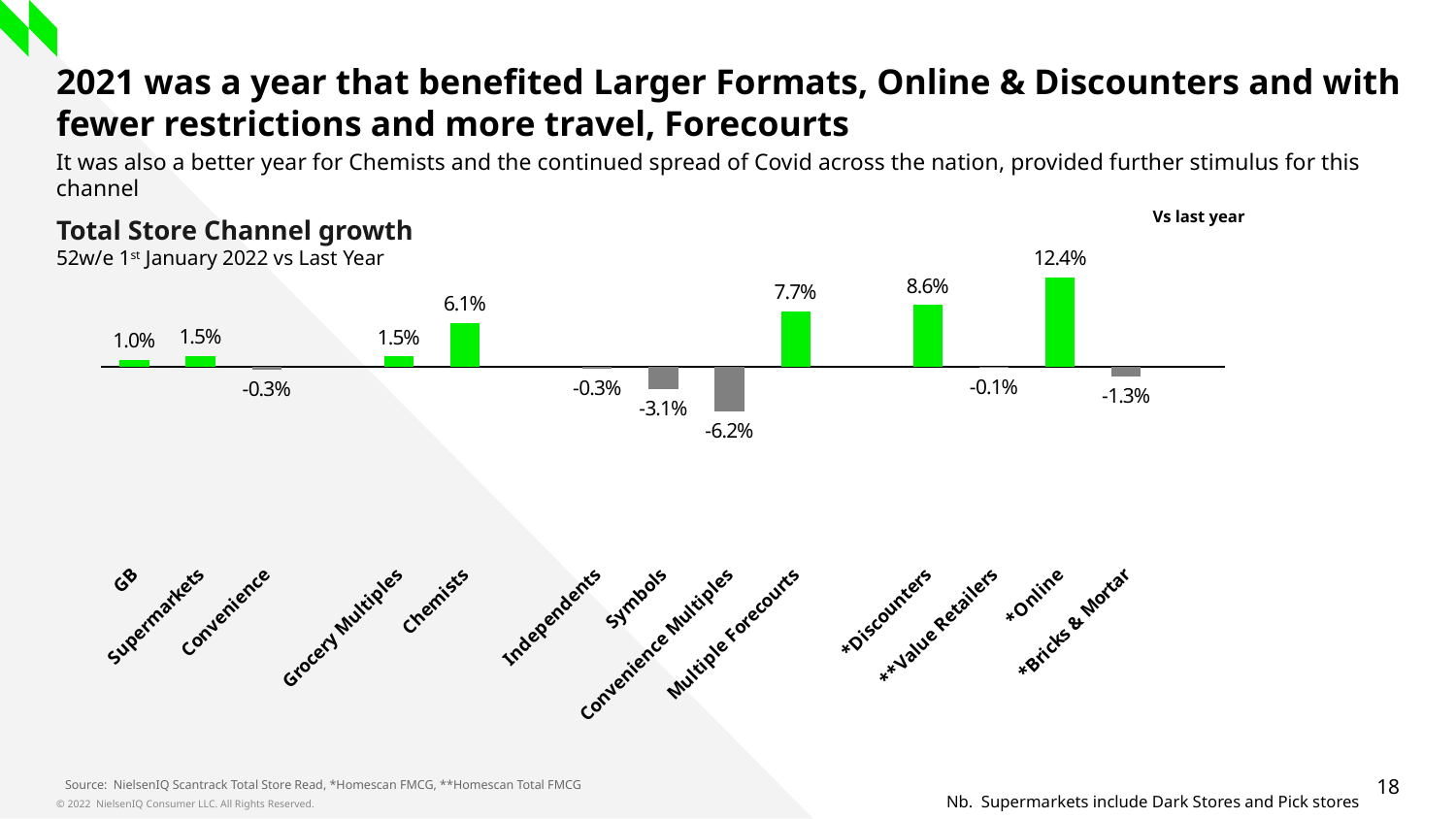
What is the growth value shown for GB? 1.0% What is the growth value shown for **Value Retailers? -0.1% What is the growth value shown for Convenience Multiples? -6.2% Which channel has the lowest growth in the chart? Convenience Multiples What is the growth value shown for Chemists? 6.1% What type of chart is shown on the slide? Bar chart Which has the larger growth value, Symbols or *Bricks & Mortar? *Bricks & Mortar What is the title of the chart? Total Store Channel growth Which channel has the highest growth in the chart? *Online How many channels are plotted in the chart? 13 What is the difference between the growth for *Discounters and Multiple Forecourts? 0.9% What is the Total Store Channel growth value for *Online? 12.4%